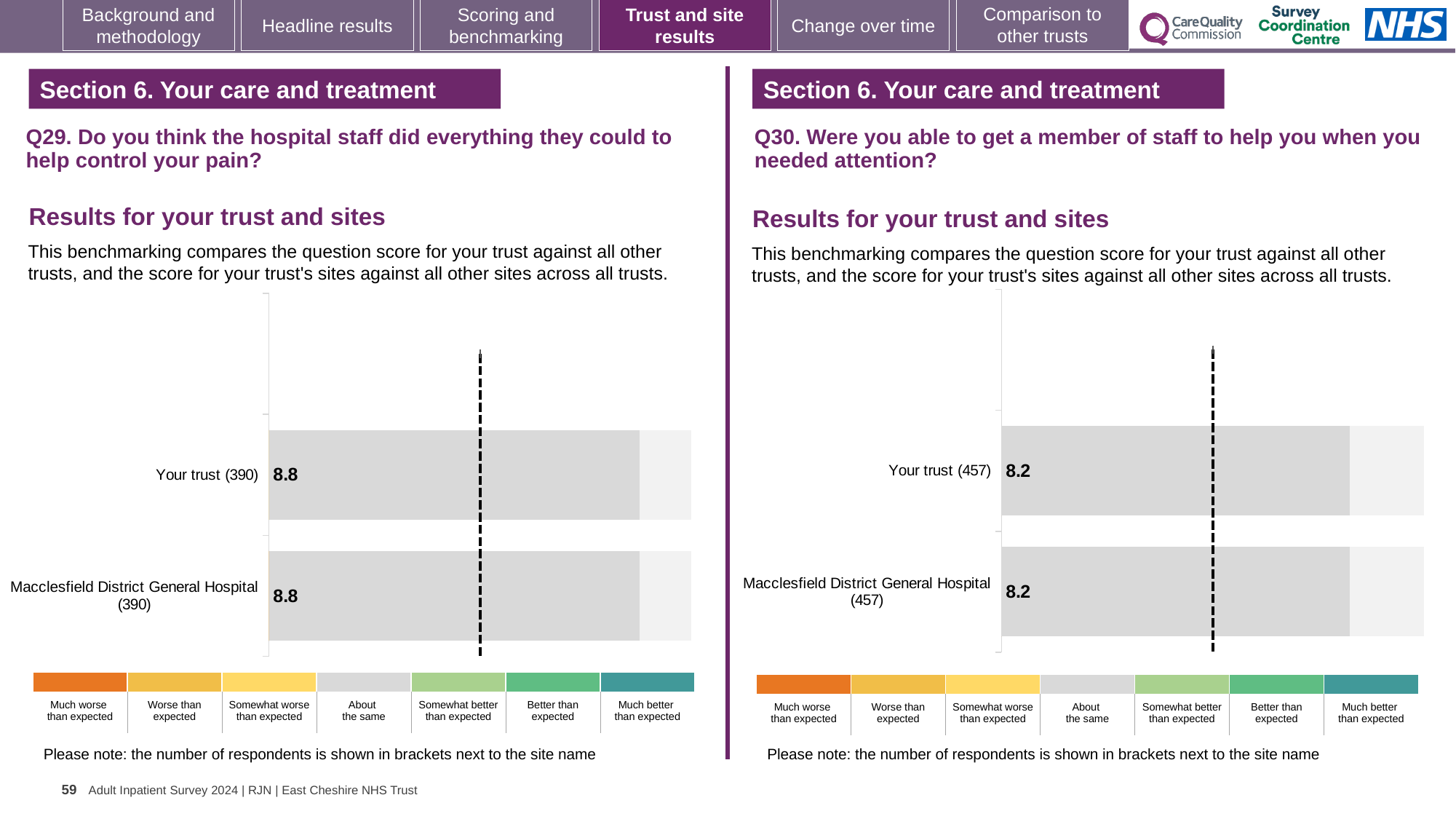
On the Q29 chart (left), how many bars are plotted? 2 On the Q30 chart (right), what is the score for Macclesfield District General Hospital? 8.2 On the Q30 chart (right), how many bars are plotted? 2 On the Q30 chart (right), what is the score for Your trust? 8.2 What kind of chart is the Q29 chart (left)? Bar chart On the Q29 chart (left), how many respondents are shown in brackets for Macclesfield District General Hospital? 390 On the Q29 chart (left), what is the score for Macclesfield District General Hospital? 8.8 Is the Your trust score on the Q29 chart (left) larger than the Your trust score on the Q30 chart (right)? Yes On the Q29 chart (left), what is the difference between the Your trust score and the Macclesfield District General Hospital score? 0 On the Q30 chart (right), how many respondents are shown in brackets for Your trust? 457 On the Q29 chart (left), what is the score for Your trust? 8.8